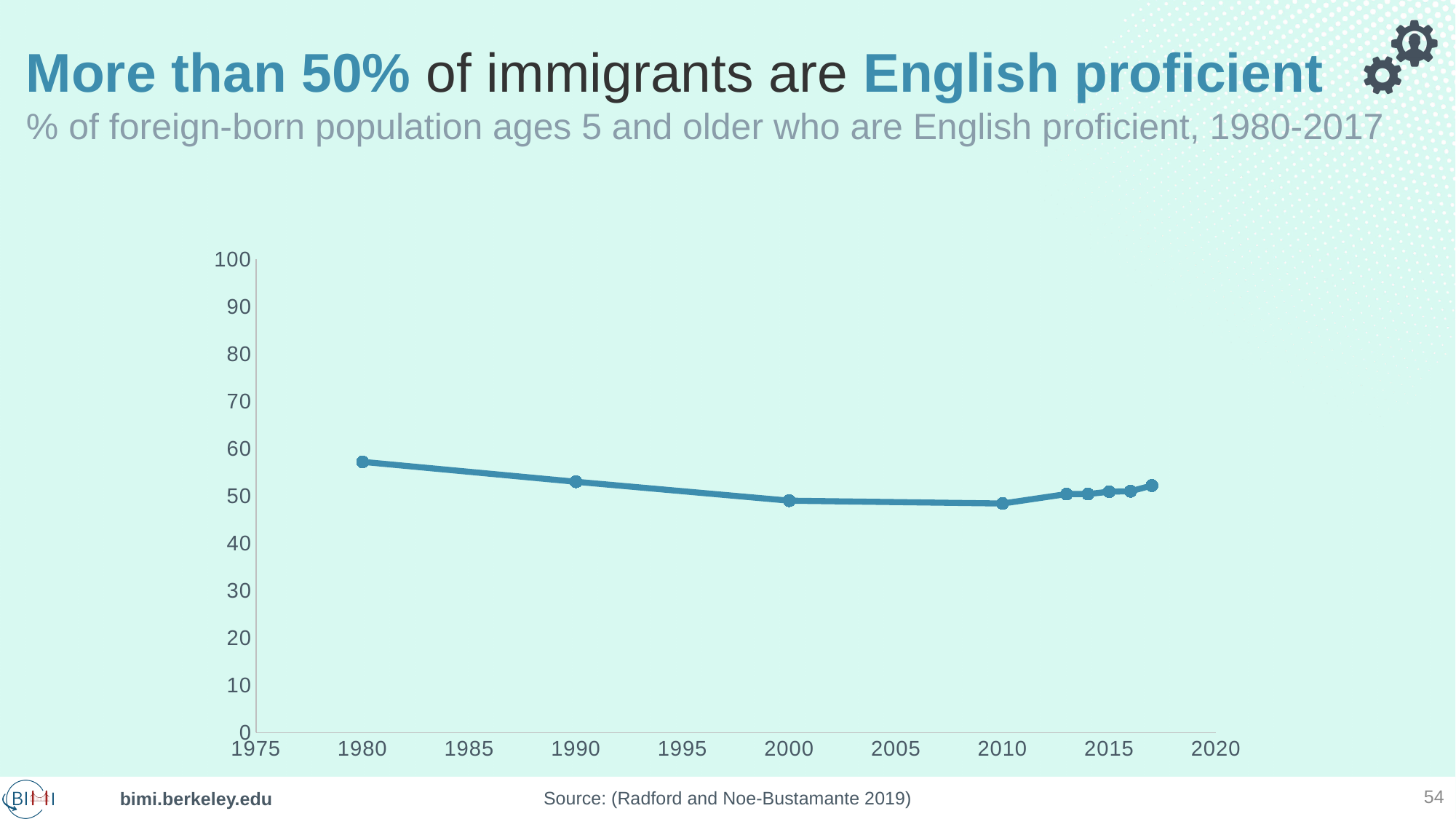
How many data points are plotted on the line? 9 Which is larger, the value for 2010 or the value for 2017? 2017 Is the value for 2017 greater or less than 50? greater Is the value for 1980 greater or less than 50? greater Which is larger, the value for 1980 or the value for 1990? 1980 What kind of chart is shown on the slide? line chart Which year has the highest value on the chart? 1980 What is the source cited for the chart? Radford and Noe-Bustamante 2019 Is the value for 1980 greater or less than 60? less Do the values rise or fall from 1980 to 2010? fall